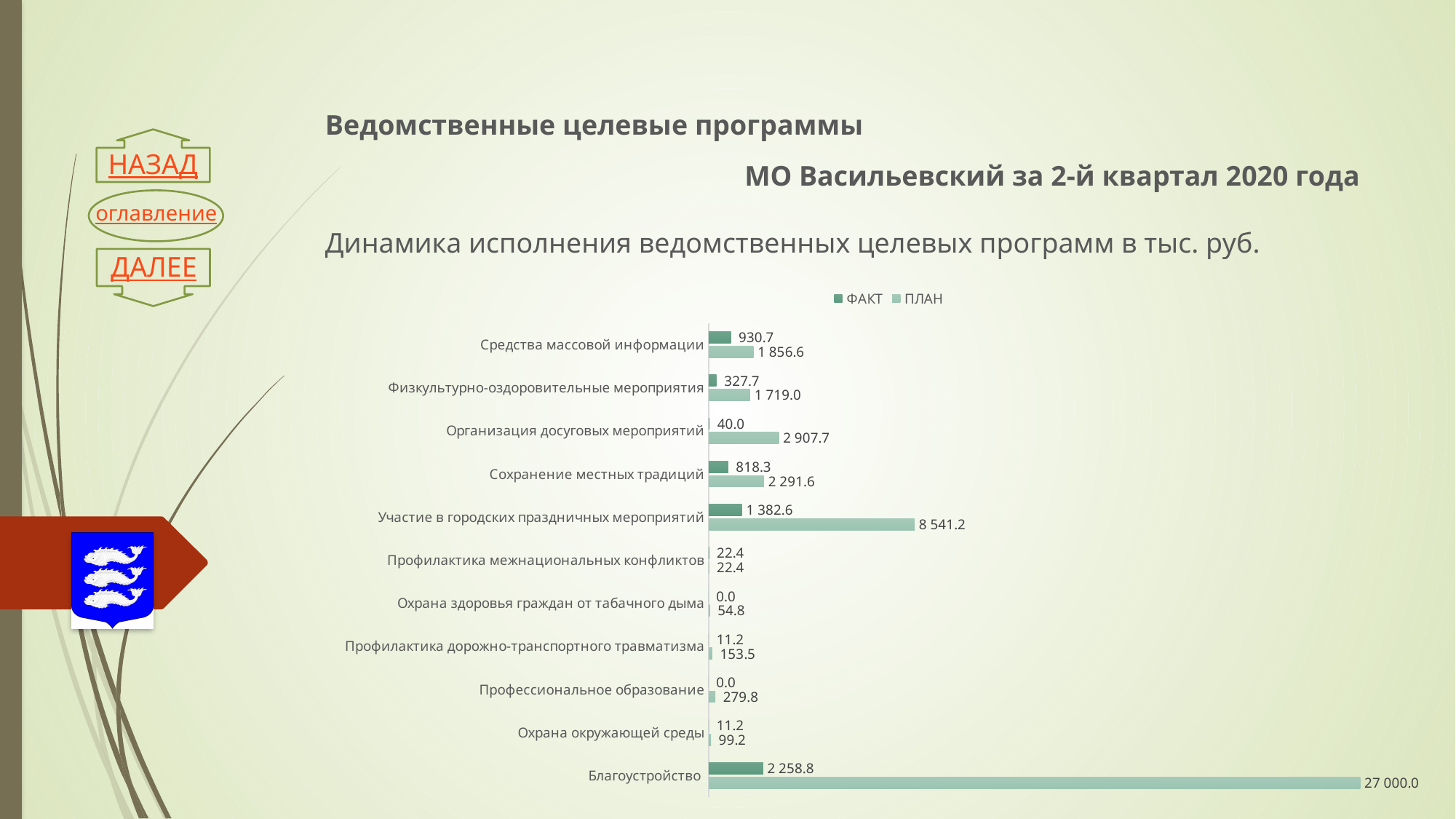
Which is larger: the ФАКТ value for Сохранение местных традиций or the ФАКТ value for Физкультурно-оздоровительные мероприятия? Сохранение местных традиций What are the two series named in the legend? ФАКТ and ПЛАН What is the difference between the ПЛАН and ФАКТ values for Средства массовой информации? 925.9 Which category has the lowest ПЛАН value? Профилактика межнациональных конфликтов Which category has the highest ФАКТ value? Благоустройство How many series does the legend list? 2 What is the ПЛАН value for Благоустройство? 27 000.0 What is the difference between the ПЛАН and ФАКТ values for Благоустройство? 24 741.2 What is the ПЛАН value for Организация досуговых мероприятий? 2 907.7 What is the ФАКТ value for Участие в городских праздничных мероприятиях? 1 382.6 How many categories are shown on the chart? 11 What type of chart is shown on the slide? Bar chart